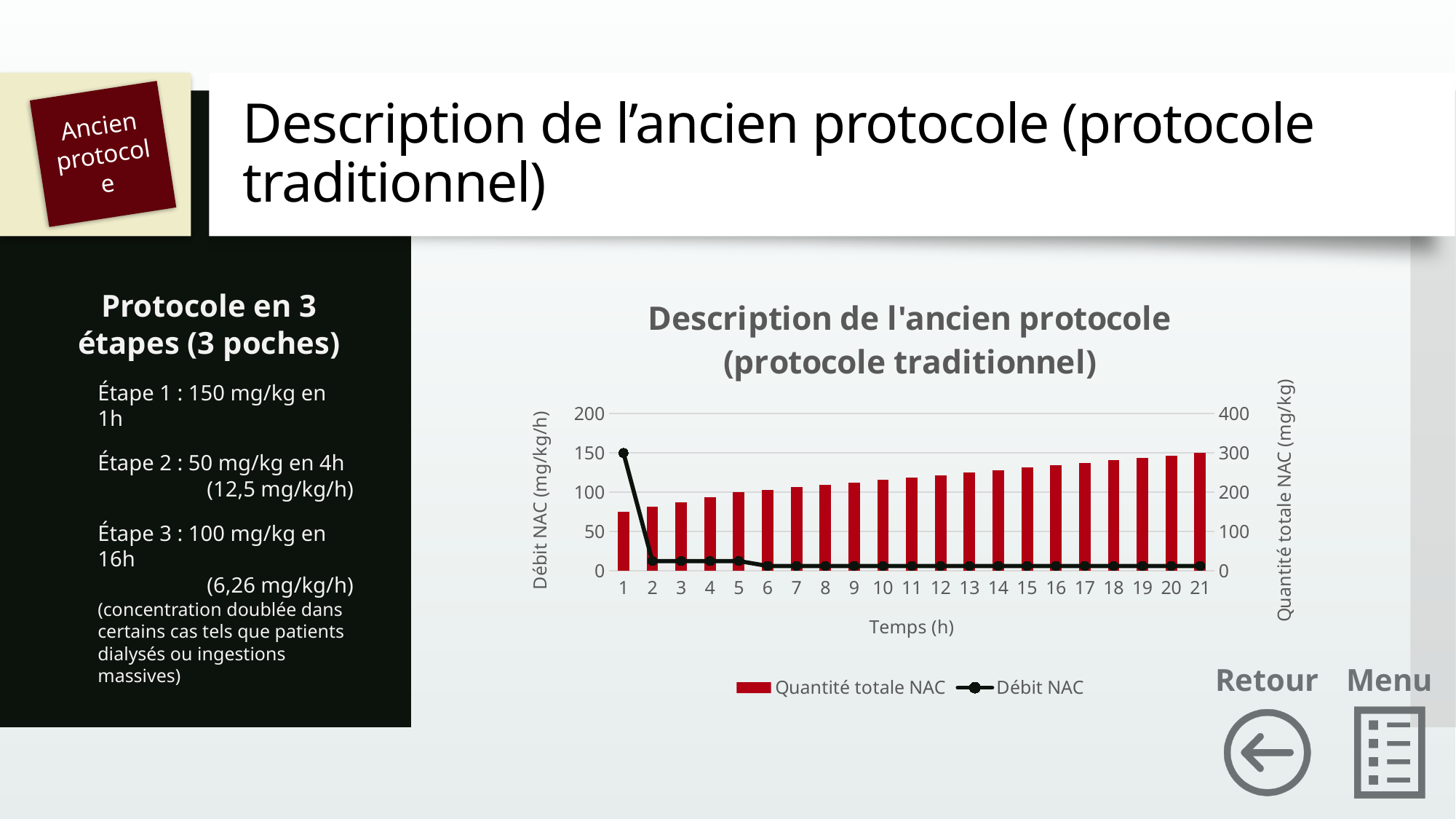
At which time (h) is the Quantité totale NAC bar lowest? 1 What is the label of the chart's x axis? Temps (h) Is the Quantité totale NAC value at time 1 greater or less than 200 mg/kg? less Is the Quantité totale NAC value at time 21 greater or less than 200 mg/kg? greater What is the Débit NAC value at time 1 (h)? 150 At which time (h) is the Quantité totale NAC bar highest? 21 How many time points are shown along the x axis of the chart? 21 What is the title of the chart? Description de l'ancien protocole (protocole traditionnel) What kind of chart is shown on the slide? A combined bar and line chart Do the Quantité totale NAC bars rise or fall as time increases along the x axis? Rise How many series does the chart legend list? 2 Which is larger, the Débit NAC at time 1 or at time 2? Time 1